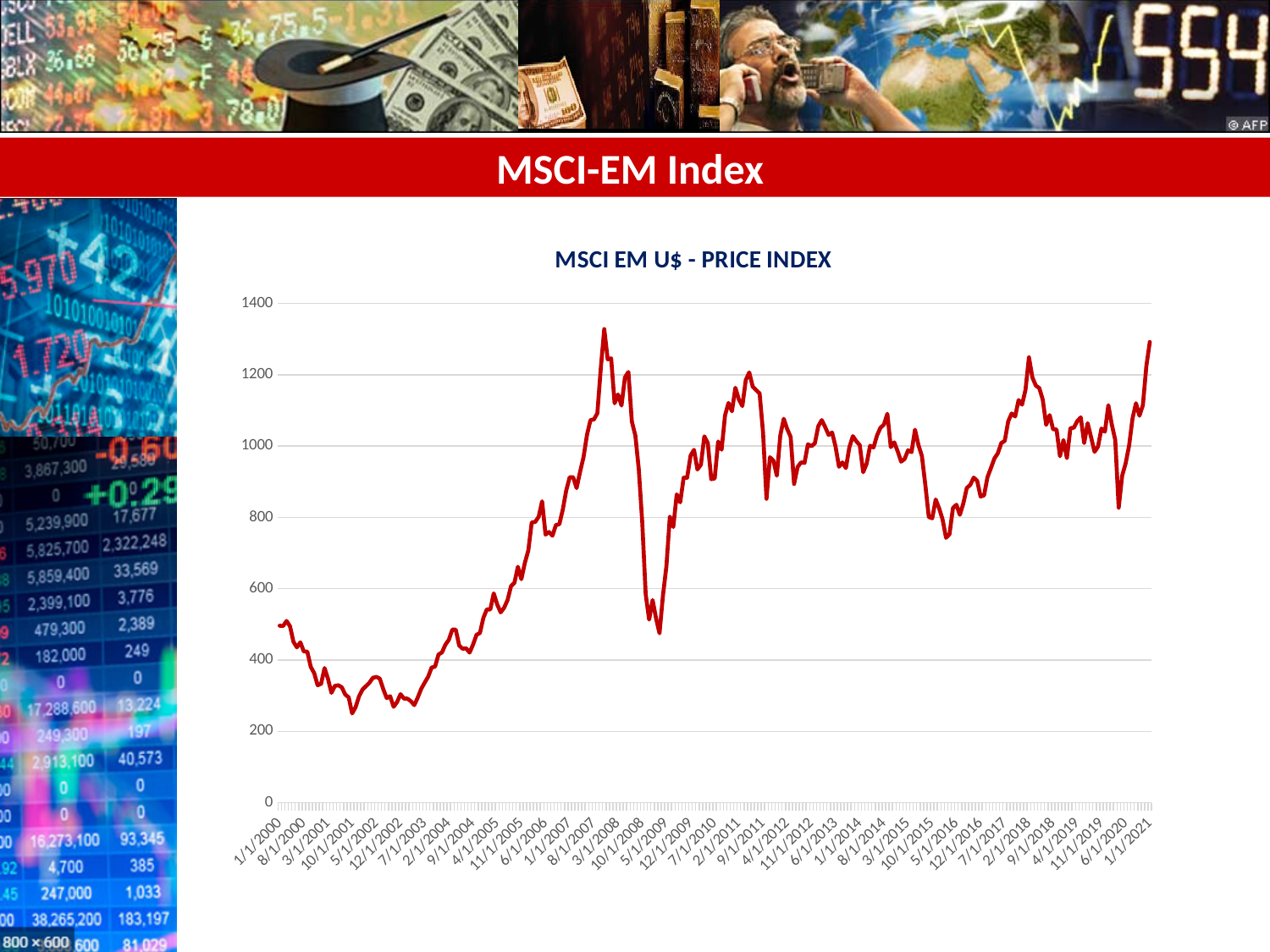
Does the index rise or fall between 1/1/2003 and 1/1/2007? rise What is the title printed above the chart? MSCI EM U$ - PRICE INDEX What colour is the line plotted in the chart? Red Is the value of the index at 7/1/2003 greater or less than 600? less Is the value of the index at 1/1/2021 greater or less than 1200? greater Is the value of the index at 1/1/2000 greater or less than 400? greater What kind of chart is shown on the slide? Line chart Does the index rise or fall between 1/1/2008 and 10/1/2008? fall Does the index rise or fall overall between 1/1/2000 and 1/1/2021? rise